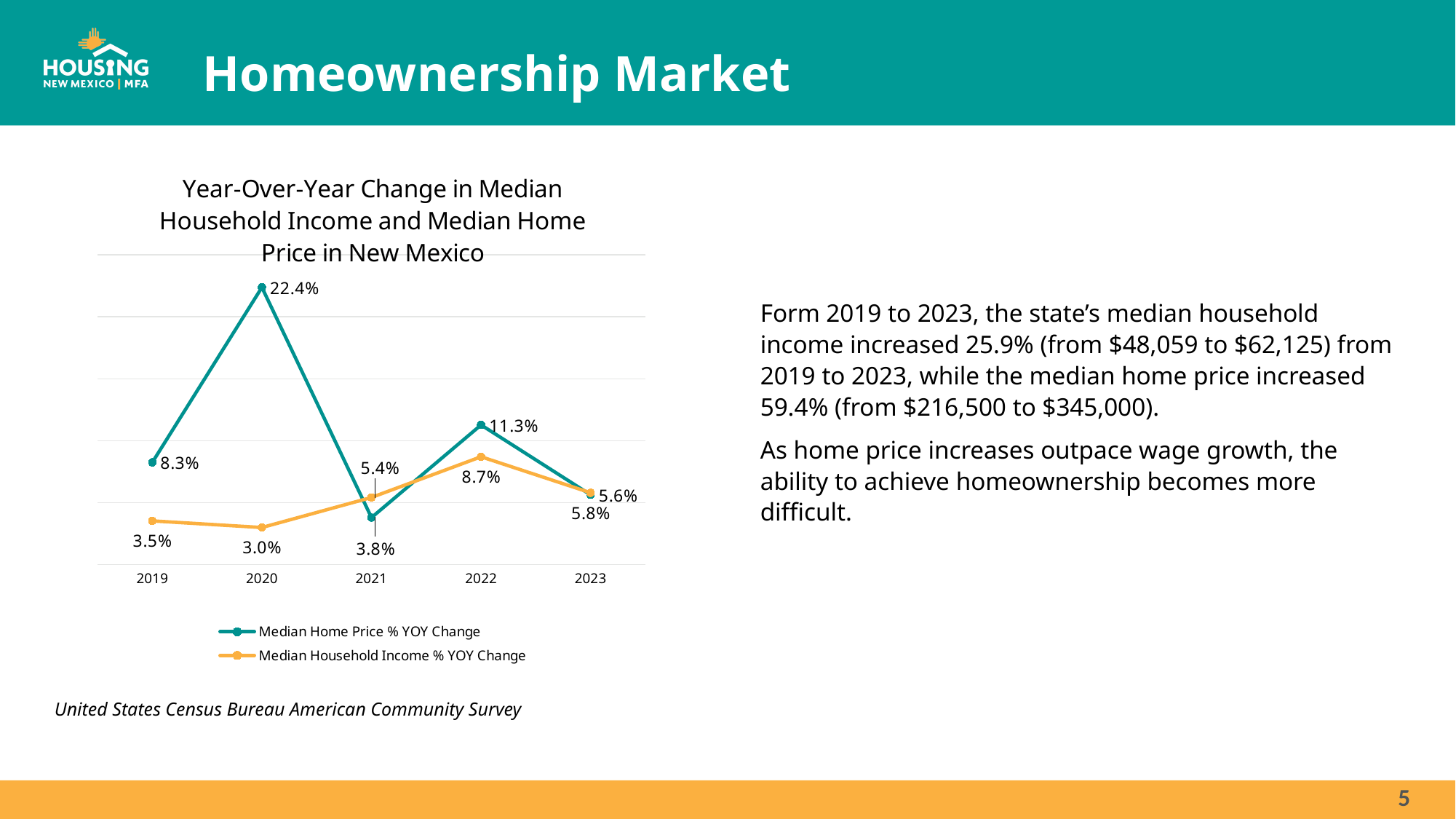
What was the Median Home Price % YOY Change in 2019? 8.3% What was the Median Household Income % YOY Change in 2022? 8.7% In which year was the Median Home Price % YOY Change highest? 2020 Did the Median Household Income % YOY Change rise or fall from 2020 to 2022? Rise In which year was the Median Household Income % YOY Change lowest? 2020 How many series does the chart's legend list? 2 What was the Median Home Price % YOY Change in 2020? 22.4% In 2021, which was larger: the Median Home Price % YOY Change or the Median Household Income % YOY Change? Median Household Income % YOY Change What type of chart is shown on the slide? Line chart How many years are shown on the x axis of the chart? 5 What was the Median Household Income % YOY Change in 2021? 5.4% What is the difference between the Median Home Price % YOY Change and the Median Household Income % YOY Change in 2020? 19.4%